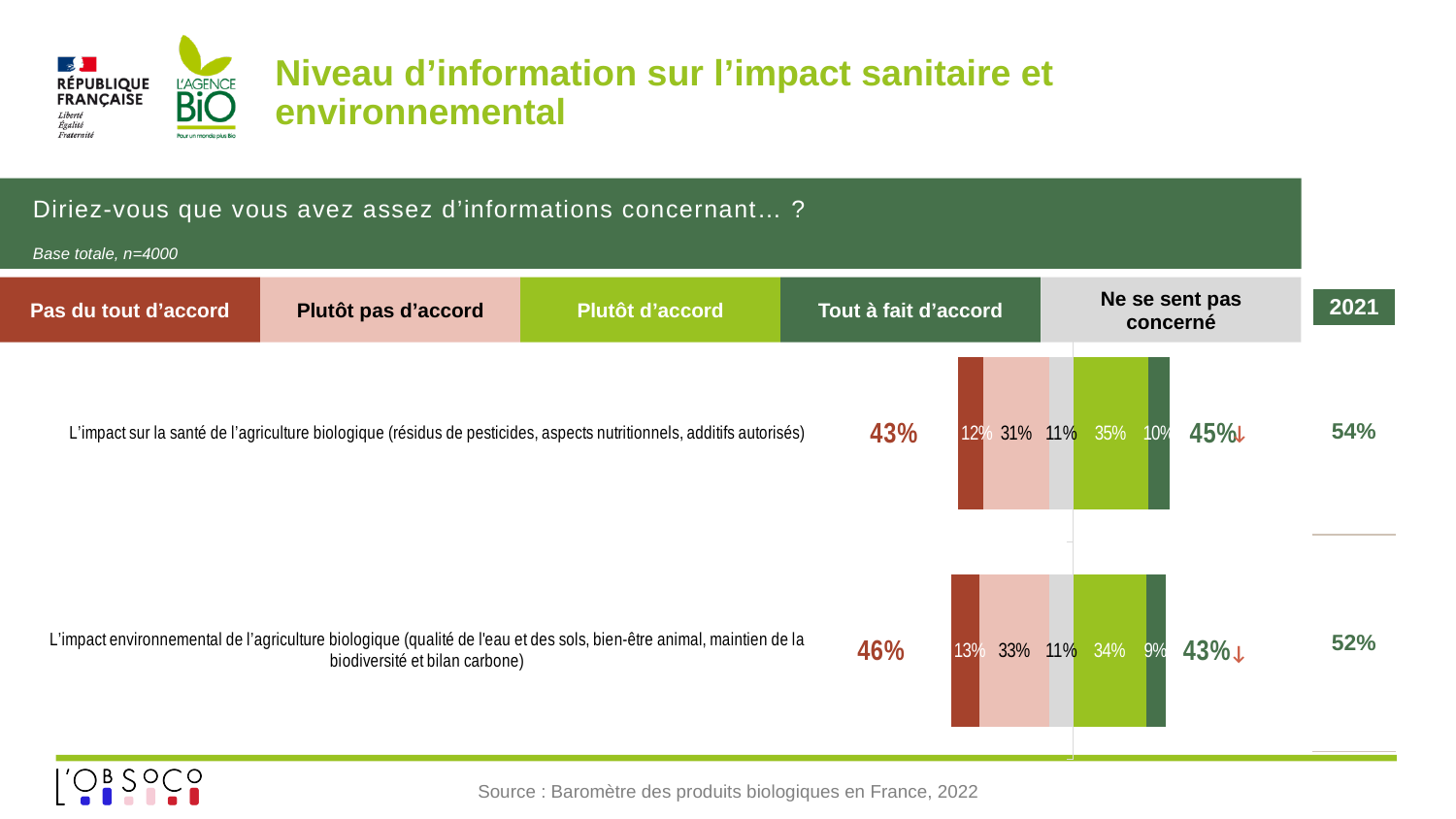
How many items (rows) are plotted in the chart? 2 What percentage of respondents answered "Plutôt pas d'accord" for the health impact of organic agriculture (L'impact sur la santé)? 31% What is the "Pas du tout d'accord" value for the environmental impact row (L'impact environnemental)? 13% What percentage of respondents answered "Plutôt d'accord" for the environmental impact of organic agriculture (L'impact environnemental)? 34% Which response category has the highest share in the health impact row (L'impact sur la santé)? Plutôt d'accord What is the "Tout à fait d'accord" value for the health impact row (L'impact sur la santé)? 10% What type of chart is used on this slide? Stacked bar chart What was the 2021 value shown for the health impact row (L'impact sur la santé)? 54% Which row has the larger "Plutôt d'accord" share: the health impact row or the environmental impact row? L'impact sur la santé How many response categories does the legend list? 5 Which response category has the lowest share in the environmental impact row (L'impact environnemental)? Tout à fait d'accord What is the difference between the "Plutôt pas d'accord" values for the environmental impact row and the health impact row? 2%